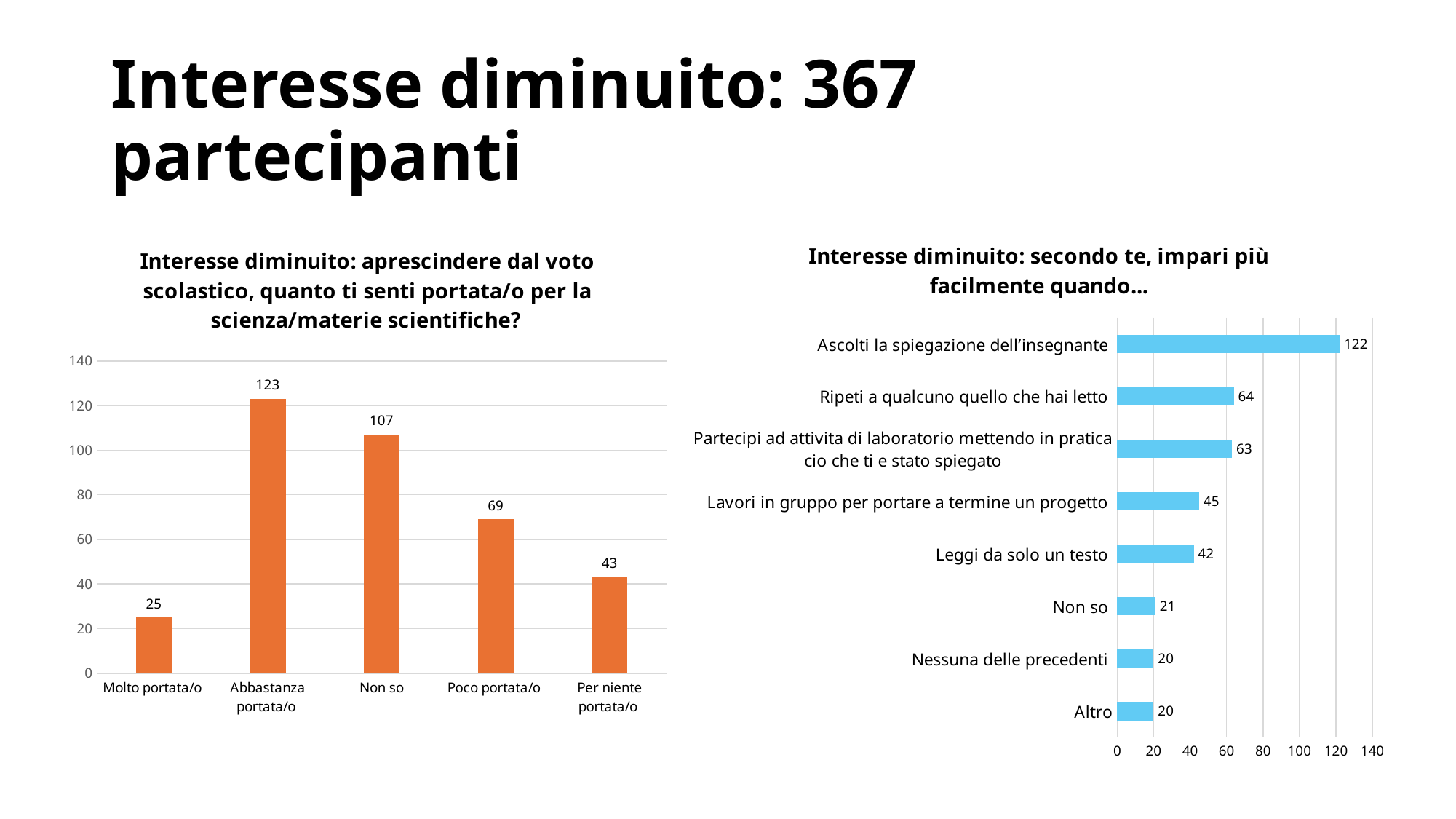
In the right chart (impari più facilmente quando…), what is the difference between "Ascolti la spiegazione dell'insegnante" and "Ripeti a qualcuno quello che hai letto"? 58 In the left chart (quanto ti senti portata/o per la scienza), what is the value for "Non so"? 107 In the left chart (quanto ti senti portata/o per la scienza), which category has the highest value? Abbastanza portata/o In the left chart (quanto ti senti portata/o per la scienza), which is larger: "Per niente portata/o" or "Molto portata/o"? Per niente portata/o What colour are the bars in the left chart (quanto ti senti portata/o per la scienza)? Orange In the right chart (impari più facilmente quando…), which category has the highest value? Ascolti la spiegazione dell'insegnante In the left chart (quanto ti senti portata/o per la scienza), which category has the lowest value? Molto portata/o In the right chart (impari più facilmente quando…), what is the value for "Lavori in gruppo per portare a termine un progetto"? 45 In the left chart (quanto ti senti portata/o per la scienza), what is the difference between "Abbastanza portata/o" and "Poco portata/o"? 54 In the right chart (impari più facilmente quando…), how many categories are shown? 8 What type of chart is the right chart (impari più facilmente quando…)? Bar chart In the left chart (quanto ti senti portata/o per la scienza), how many categories are shown? 5